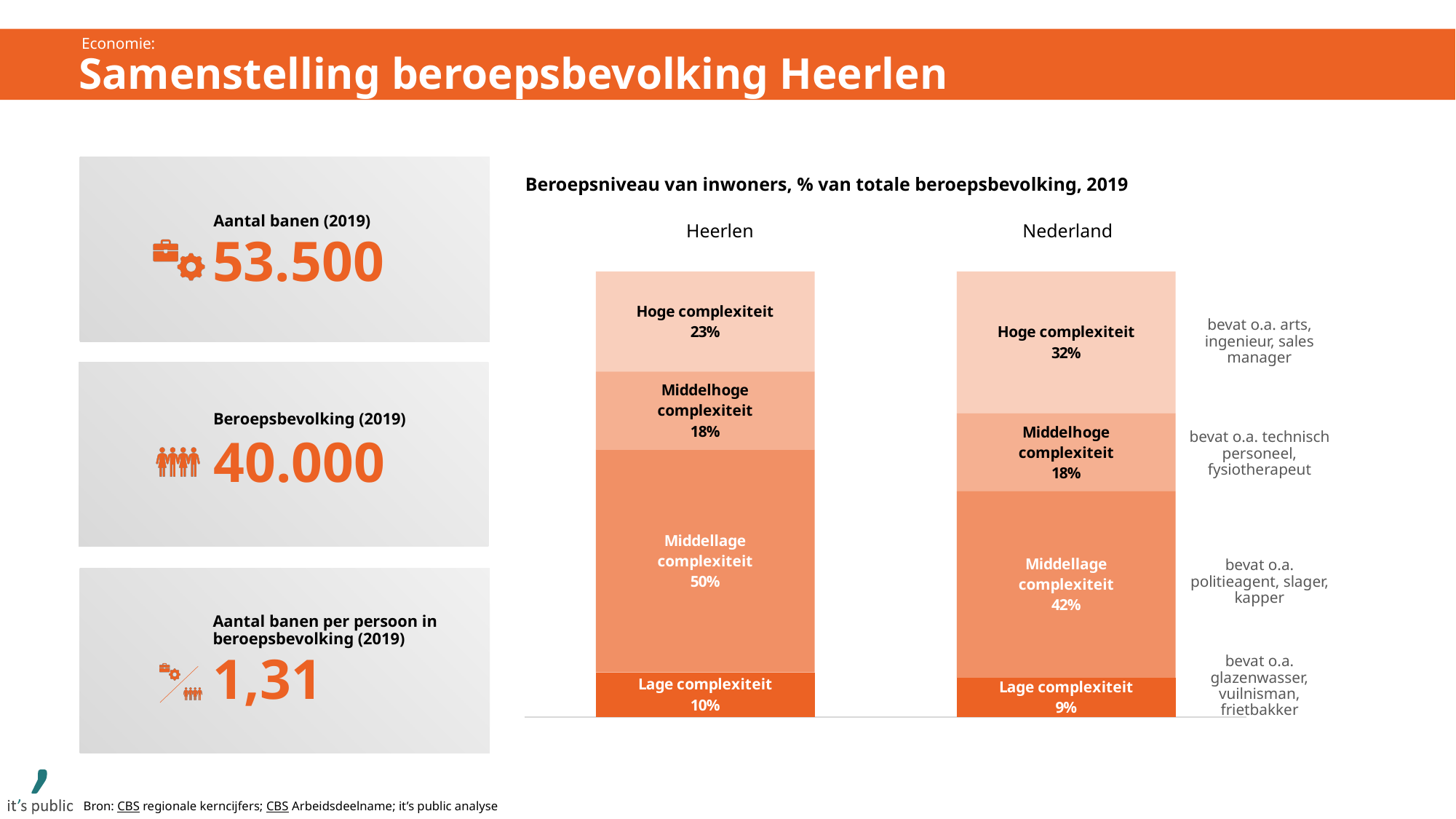
What is the difference between the Hoge complexiteit share for Nederland and for Heerlen? 9 percentage points Which segment is the largest in the Heerlen bar? Middellage complexiteit How many bars does the chart show? 2 What is the value for Middellage complexiteit in the Nederland bar? 42% What kind of chart is shown on the right of the slide? Stacked bar chart What is the value for Lage complexiteit in the Heerlen bar? 10% What is the value for Middelhoge complexiteit in the Nederland bar? 18% Which segment is the smallest in the Nederland bar? Lage complexiteit What is the value for Hoge complexiteit in the Heerlen bar? 23% How many segments does each stacked bar contain? 4 Which has a larger Middellage complexiteit share, Heerlen or Nederland? Heerlen What is the title of the chart on the right of the slide? Beroepsniveau van inwoners, % van totale beroepsbevolking, 2019